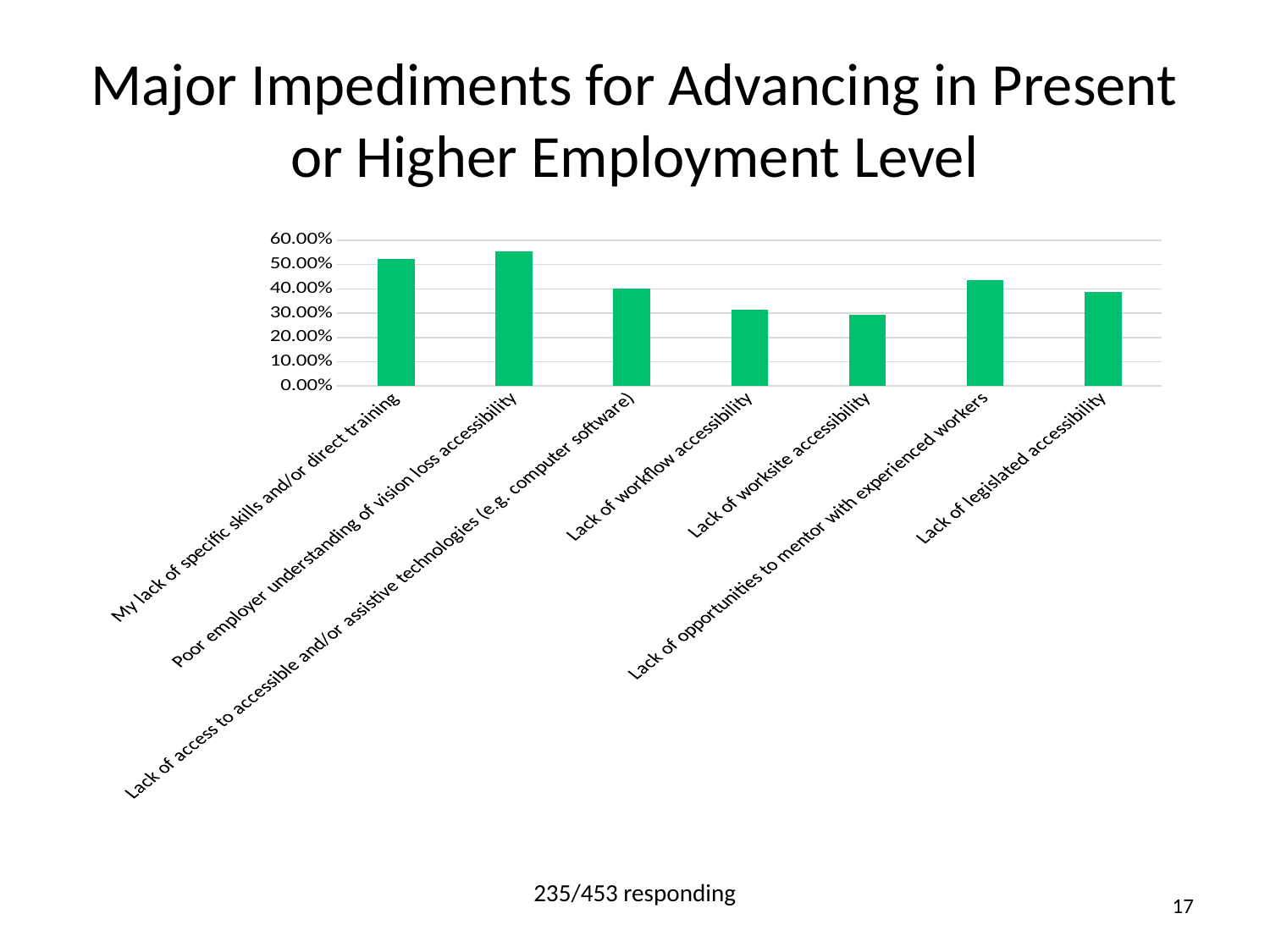
Is the value for "Lack of workflow accessibility" greater or less than 40.00%? less What is the title of the chart on the slide? Major Impediments for Advancing in Present or Higher Employment Level Which is larger: the value for "My lack of specific skills and/or direct training" or for "Lack of access to accessible and/or assistive technologies (e.g. computer software)"? My lack of specific skills and/or direct training What is the highest value shown on the chart's vertical axis? 60.00% Which impediment has the highest percentage in the chart? Poor employer understanding of vision loss accessibility Is the value for "Lack of opportunities to mentor with experienced workers" greater or less than 40.00%? greater Which is larger: the value for "Lack of opportunities to mentor with experienced workers" or for "Lack of legislated accessibility"? Lack of opportunities to mentor with experienced workers Is the value for "My lack of specific skills and/or direct training" greater or less than 40.00%? greater What kind of chart is shown on the slide? bar chart How many impediment categories are plotted in the chart? 7